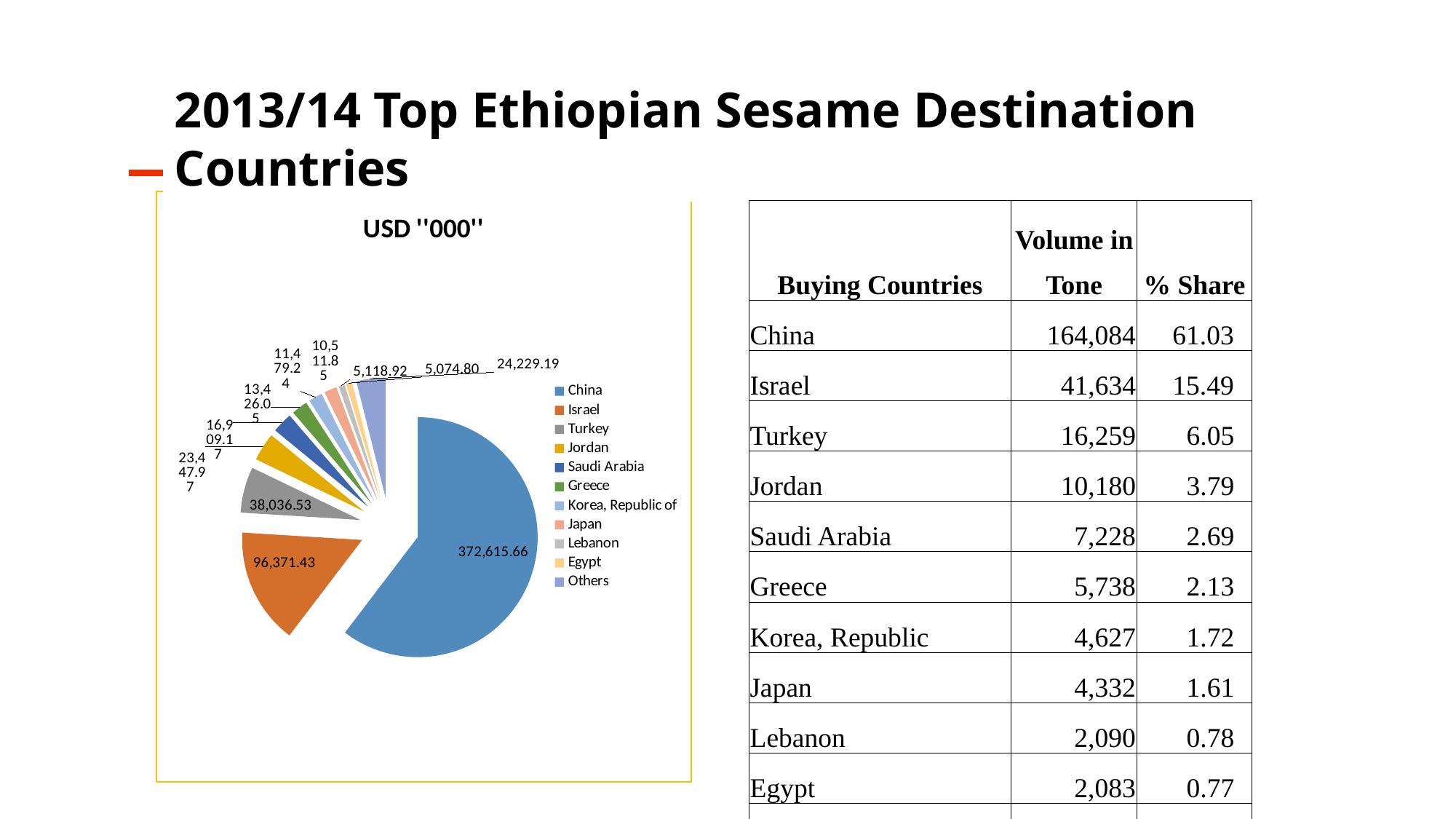
What is the title of the pie chart? USD ''000'' What colour is the China slice in the pie chart? blue Which country has the largest slice in the pie chart? China What is the difference between the values for China and Israel in the pie chart? 276,244.23 Which is larger in the pie chart, the value for Israel or the value for Turkey? Israel What is the value shown for Lebanon in the pie chart? 5,118.92 What is the value shown for Turkey in the pie chart? 38,036.53 What is the value shown for China in the pie chart? 372,615.66 What kind of chart is shown on the slide? pie chart What is the value shown for Others in the pie chart? 24,229.19 How many slices does the pie chart have? 11 What is the value shown for Israel in the pie chart? 96,371.43